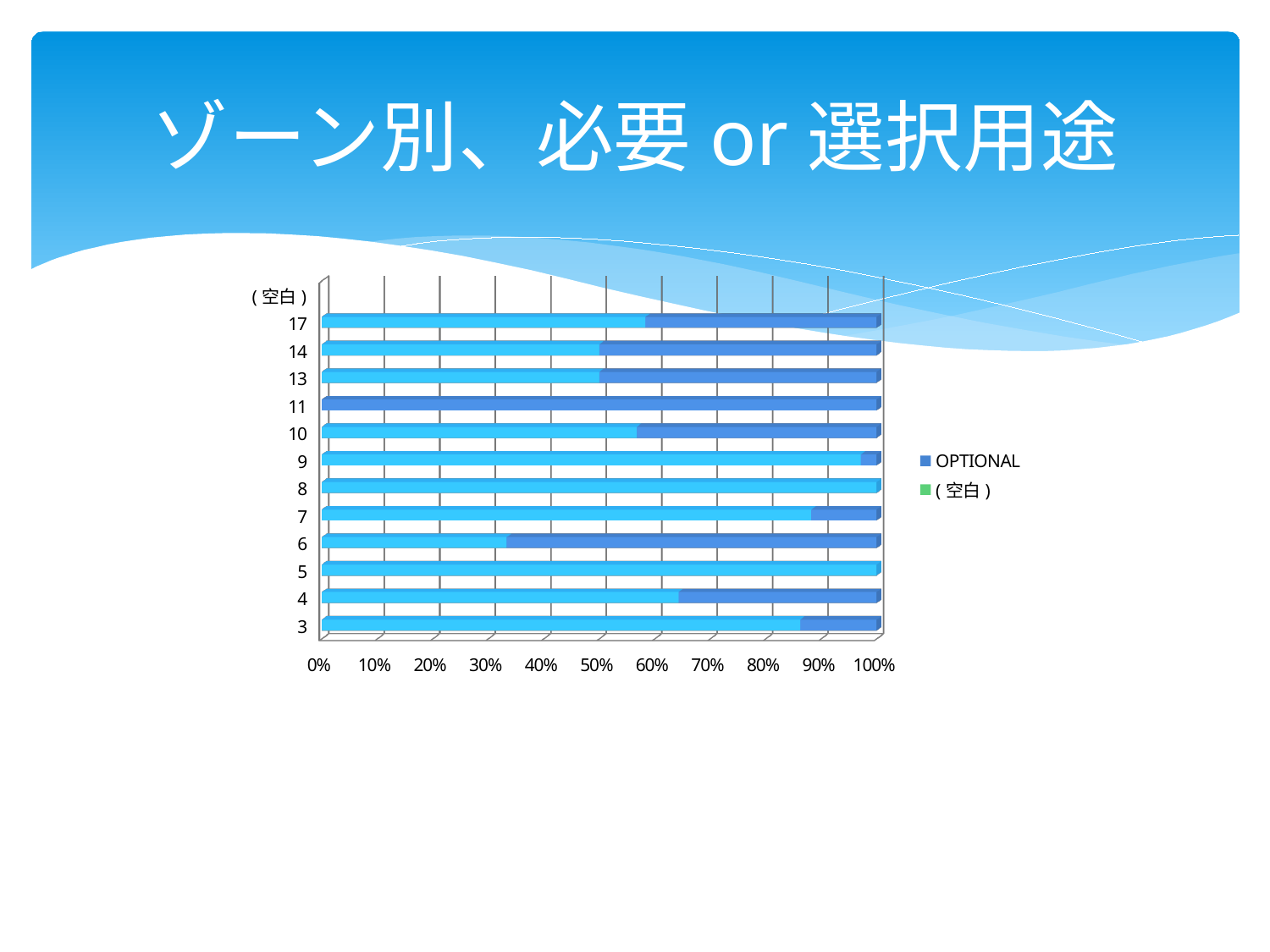
How many numbered zone categories are listed on the vertical axis? 12 Which zone has the larger OPTIONAL share, zone 6 or zone 3? 6 What colour represents the OPTIONAL series in the legend? Dark blue What kind of chart is shown on the slide? Stacked horizontal bar chart How many series does the chart legend list? 2 What is the title of the slide containing the chart? ゾーン別、必要 or 選択用途 Is the OPTIONAL share for zone 7 greater or less than 20%? less Is the light blue segment for zone 3 greater or less than 80%? greater Is the light blue segment for zone 6 greater or less than 40%? less Which zone has the largest OPTIONAL share of its bar? 11